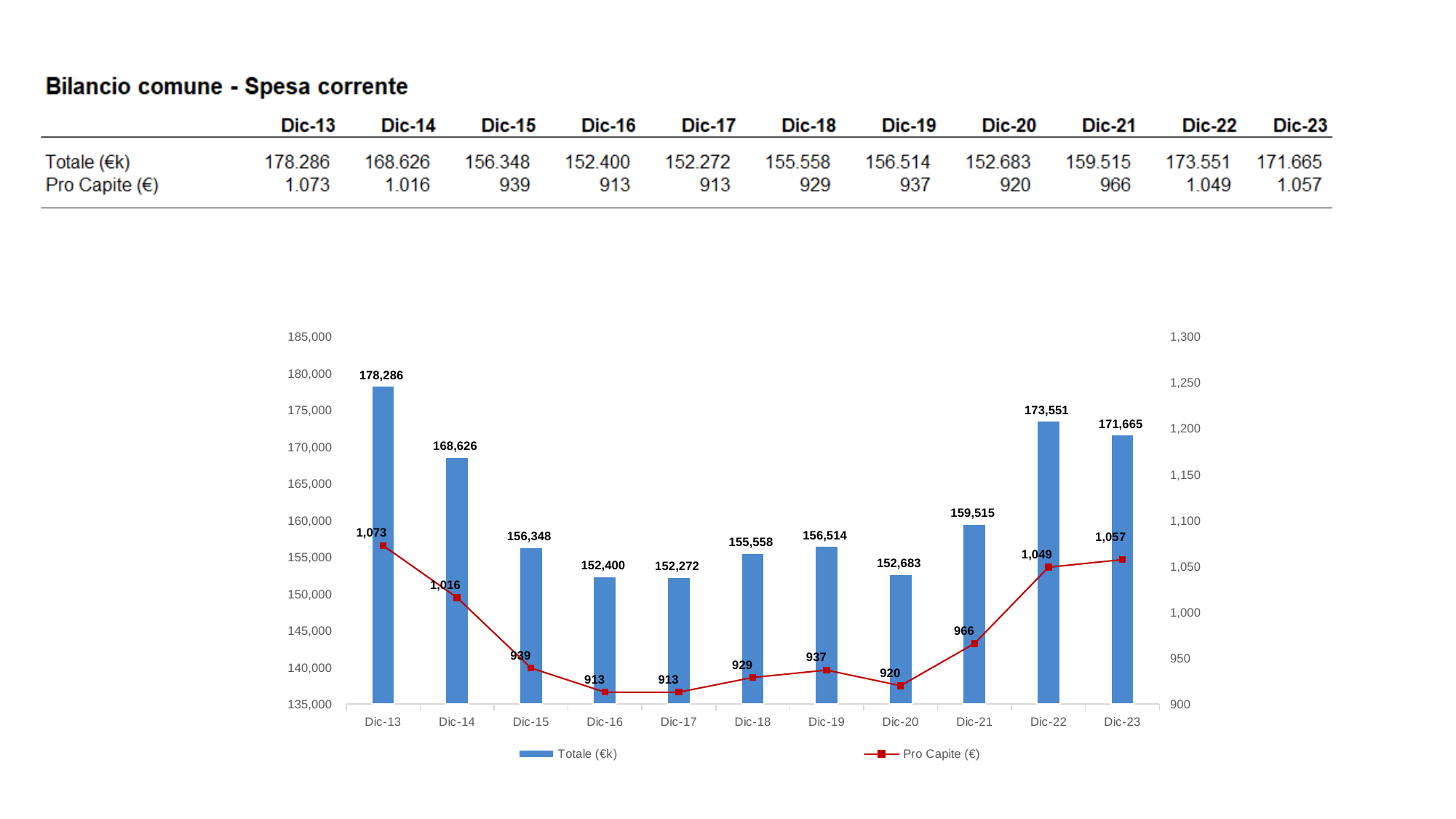
What is the difference between the Pro Capite (€) values for Dic-13 and Dic-23? 16 What kind of chart is shown on the slide? Combined bar and line chart Does the Pro Capite (€) line rise or fall from Dic-20 to Dic-23? Rise Which period has the highest Pro Capite (€) value? Dic-13 What is the Totale (€k) value for Dic-21? 159,515 Which is larger, the Totale (€k) value for Dic-14 or for Dic-22? Dic-22 How many series does the legend list? 2 Which period has the lowest Totale (€k) value? Dic-17 How many periods are shown on the x axis? 11 What is the Pro Capite (€) value for Dic-19? 937 What is the difference between the Totale (€k) values for Dic-22 and Dic-23? 1,886 Which period has the highest Totale (€k) value? Dic-13